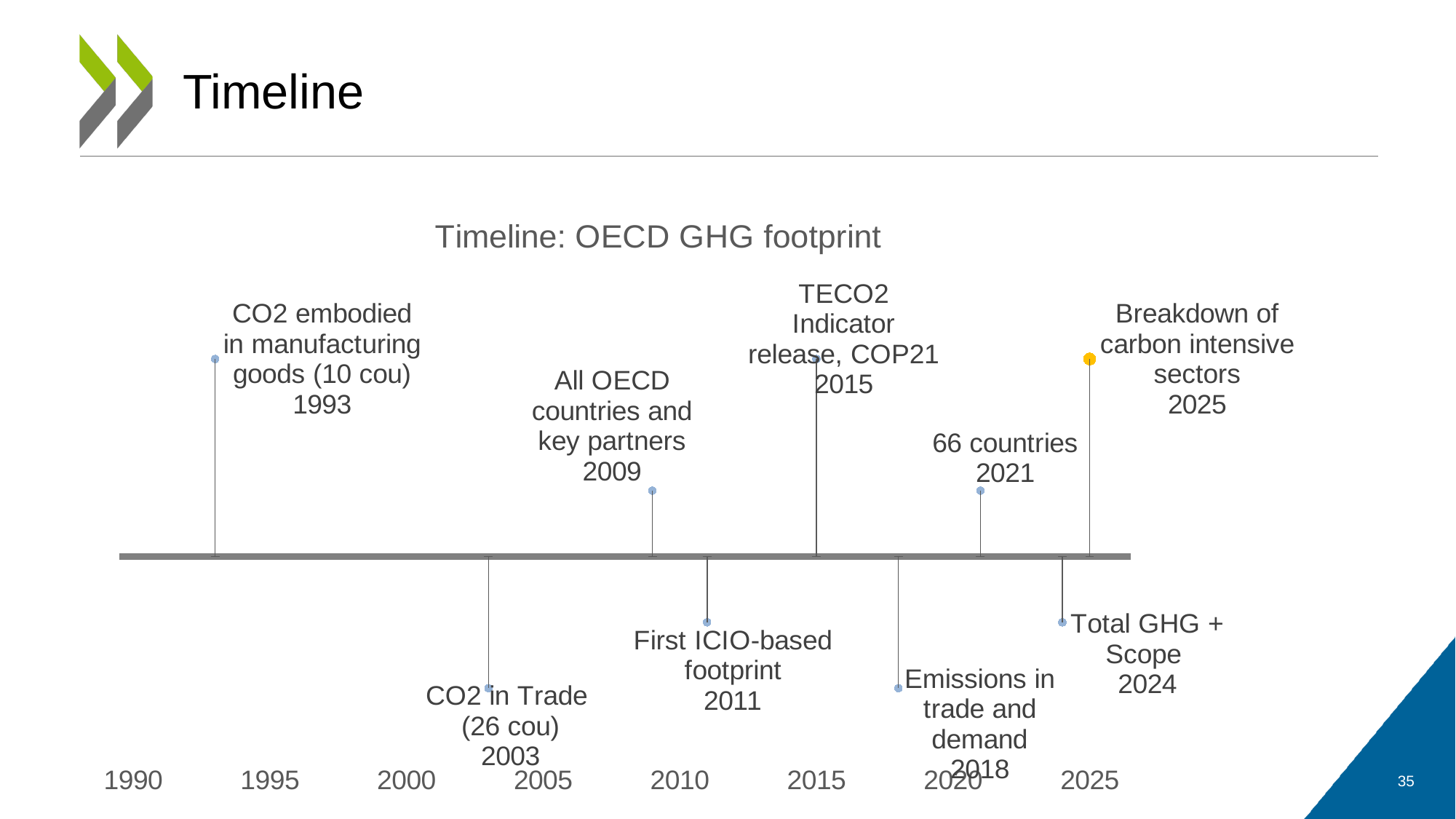
Which event is the latest on the timeline? Breakdown of carbon intensive sectors What is the title of the chart? Timeline: OECD GHG footprint In which year is the "CO2 embodied in manufacturing goods (10 cou)" event placed on the timeline? 1993 In which year is the "CO2 in Trade (26 cou)" event placed? 2003 What year is shown for the "First ICIO-based footprint" event? 2011 How many years separate the "All OECD countries and key partners" event (2009) from the "Emissions in trade and demand" event (2018)? 9 What year is shown for the "TECO2 Indicator release, COP21" event? 2015 Which event comes later: "First ICIO-based footprint" or "All OECD countries and key partners"? First ICIO-based footprint What year is shown for the "Total GHG + Scope" event? 2024 How many events are marked on the timeline? 9 What year is shown for the "66 countries" event? 2021 Which event is the earliest on the timeline? CO2 embodied in manufacturing goods (10 cou)